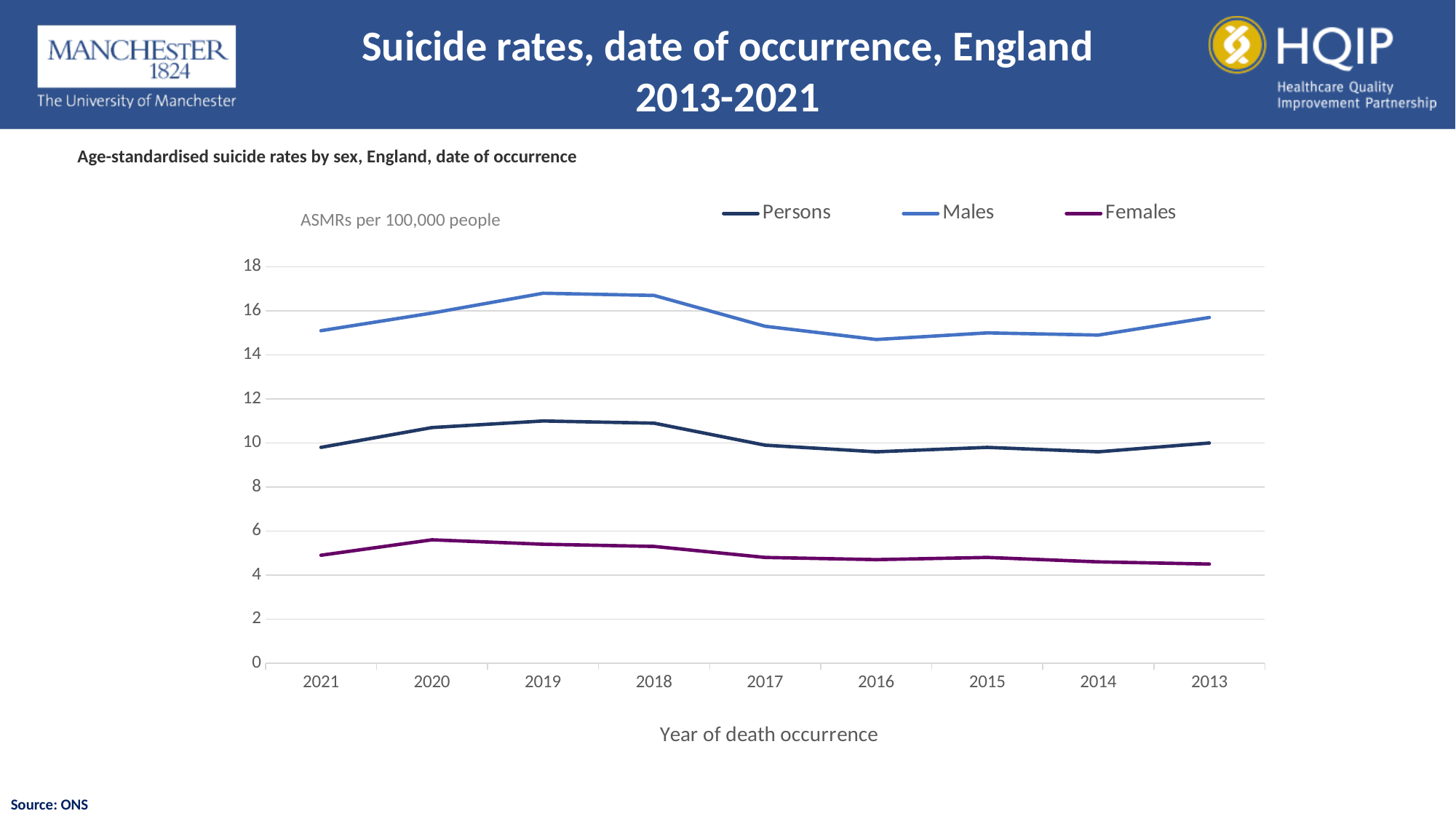
How many series does the legend list? 3 Which year has the highest value for Females? 2020 Is the value for Females in 2013 greater or less than 6? less Which is larger, the Persons value in 2020 or the Persons value in 2016? 2020 What is the title of the x axis? Year of death occurrence Is the value for Males in 2021 greater or less than 14? greater Moving left to right from 2021 to 2019, does the Males line rise or fall? rise How many years are shown on the x axis? 9 Is the value for Males in 2016 greater or less than 16? less Which is larger, the Males value in 2019 or the Males value in 2016? 2019 What kind of chart is shown on the slide? line chart